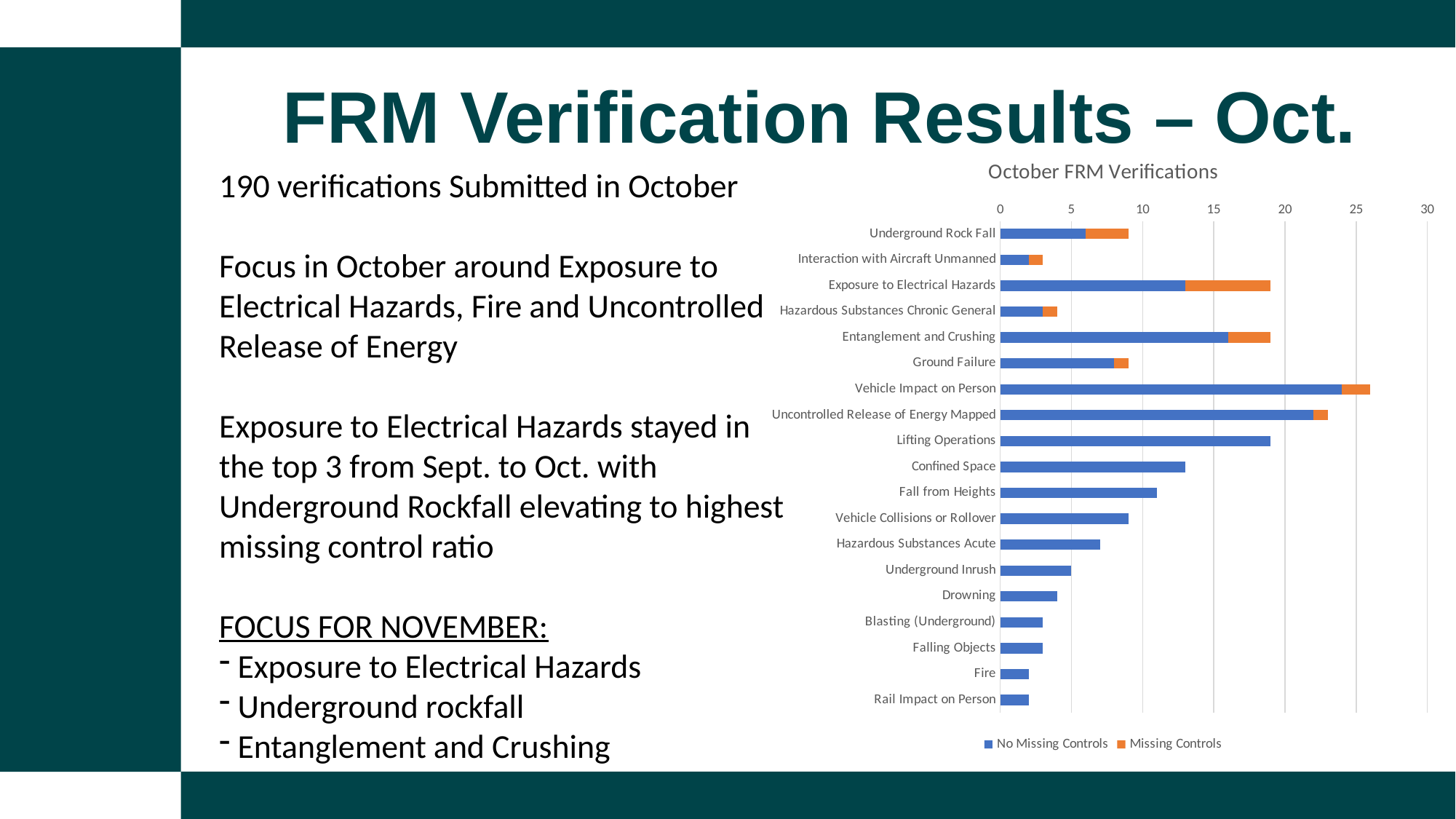
What is the title of the chart? October FRM Verifications Is the value for Drowning greater or less than 5? less Is the value for Confined Space greater or less than 10? greater How many categories are plotted on the chart? 19 Which has a larger value, Lifting Operations or Confined Space? Lifting Operations Which colour represents the Missing Controls series in the chart? Orange Is the total value for Vehicle Impact on Person greater or less than 20? greater How many series does the chart legend list? 2 Which category has the highest total bar length? Vehicle Impact on Person What kind of chart is shown on the slide? Bar chart Which has a larger total value, Entanglement and Crushing or Ground Failure? Entanglement and Crushing